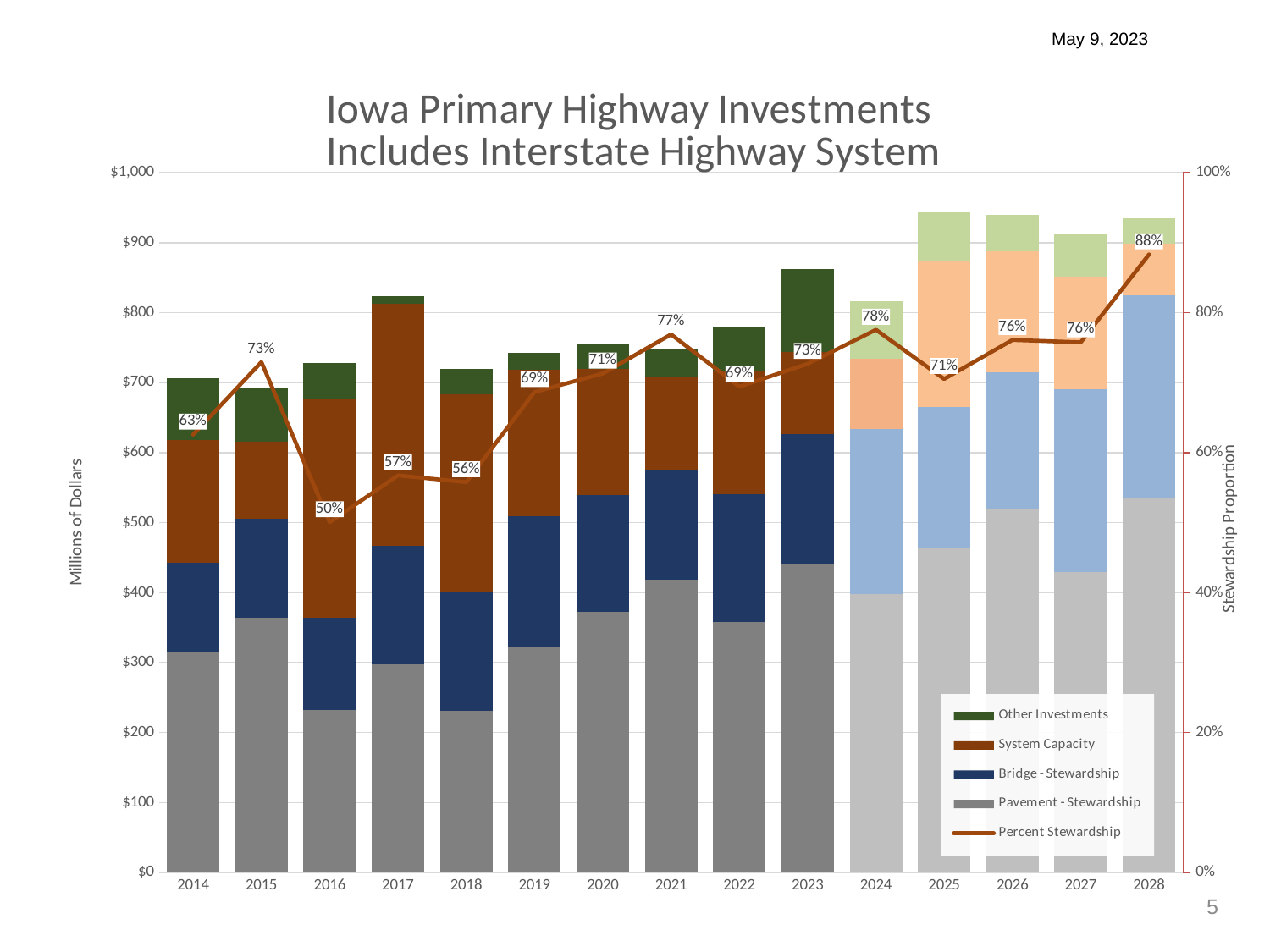
What is the Percent Stewardship value for 2021? 77% What is the Percent Stewardship value for 2016? 50% Is the total stacked bar value for 2025 greater or less than $900? greater What is the label of the right-hand vertical axis? Stewardship Proportion How many years are shown on the x axis? 15 Is the total stacked bar value for 2017 greater or less than $800? greater Which year has a higher Percent Stewardship value, 2021 or 2023? 2021 What is the Percent Stewardship value for 2024? 78% Which year has the highest Percent Stewardship value? 2028 Which year has the lowest Percent Stewardship value? 2016 What is the difference between the Percent Stewardship values for 2028 and 2016? 38 percentage points How many series does the legend list? 5